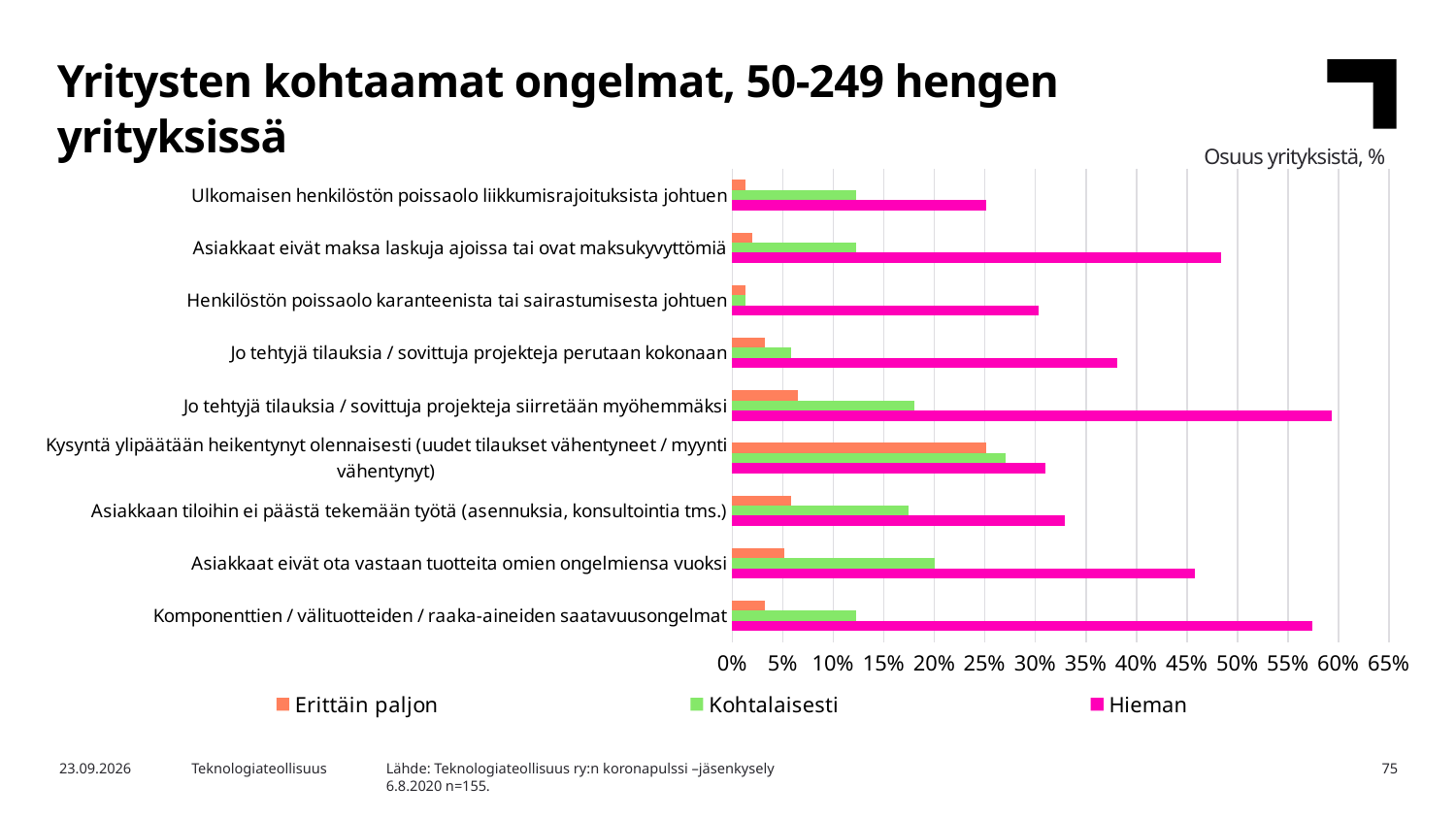
What unit label is shown above the chart? Osuus yrityksistä, % What kind of chart is shown on the slide? Bar chart How many series does the legend list? 3 Is the 'Kohtalaisesti' value for 'Asiakkaat eivät ota vastaan tuotteita omien ongelmiensa vuoksi' greater or less than 15%? greater How many problem categories are plotted on the chart? 9 Which colour represents the 'Hieman' series in the chart? Magenta (pink) Which category has the highest value for the 'Kohtalaisesti' series? Kysyntä ylipäätään heikentynyt olennaisesti (uudet tilaukset vähentyneet / myynti vähentynyt) Is the 'Hieman' value for 'Henkilöstön poissaolo karanteenista tai sairastumisesta johtuen' greater or less than 35%? less Which category has the lowest value for the 'Hieman' series? Ulkomaisen henkilöstön poissaolo liikkumisrajoituksista johtuen For the 'Hieman' series, which is larger: 'Jo tehtyjä tilauksia / sovittuja projekteja perutaan kokonaan' or 'Asiakkaan tiloihin ei päästä tekemään työtä (asennuksia, konsultointia tms.)'? Jo tehtyjä tilauksia / sovittuja projekteja perutaan kokonaan Is the 'Hieman' value for 'Asiakkaat eivät maksa laskuja ajoissa tai ovat maksukyvyttömiä' greater or less than 45%? greater Which category has the highest value for the 'Erittäin paljon' series? Kysyntä ylipäätään heikentynyt olennaisesti (uudet tilaukset vähentyneet / myynti vähentynyt)